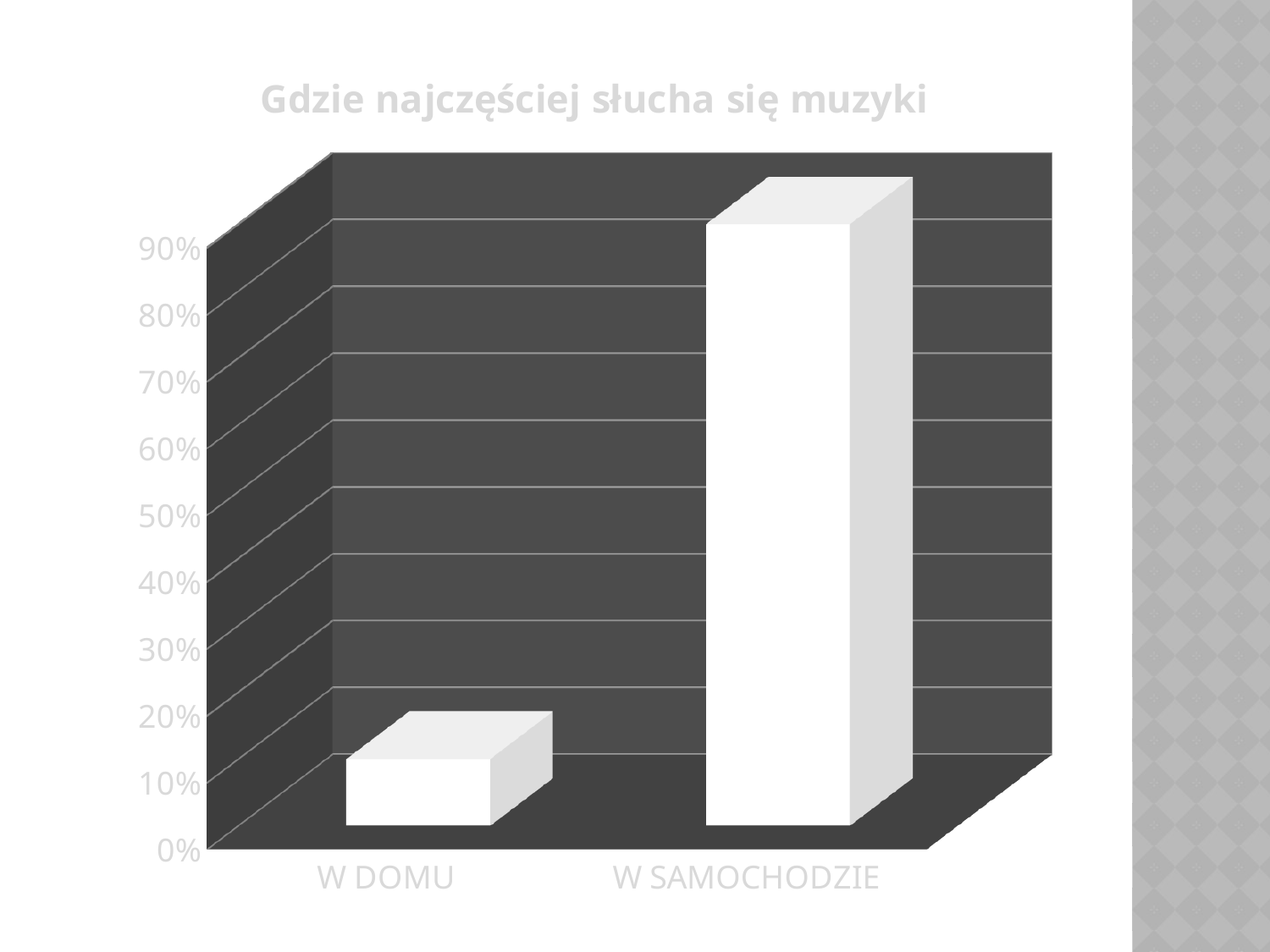
How many categories are shown on the x axis of the chart? 2 What is the title of the chart? Gdzie najczęściej słucha się muzyki What is the highest value labelled on the vertical axis? 90% Is the value for W SAMOCHODZIE greater or less than 70%? greater Do the values rise or fall from W DOMU to W SAMOCHODZIE? rise Which is larger, the value for W DOMU or the value for W SAMOCHODZIE? W SAMOCHODZIE What kind of chart is shown on the slide? bar chart Is the value for W DOMU greater or less than 30%? less Which category has the lowest value? W DOMU Which category has the highest value? W SAMOCHODZIE Is the value for W SAMOCHODZIE greater or less than 50%? greater